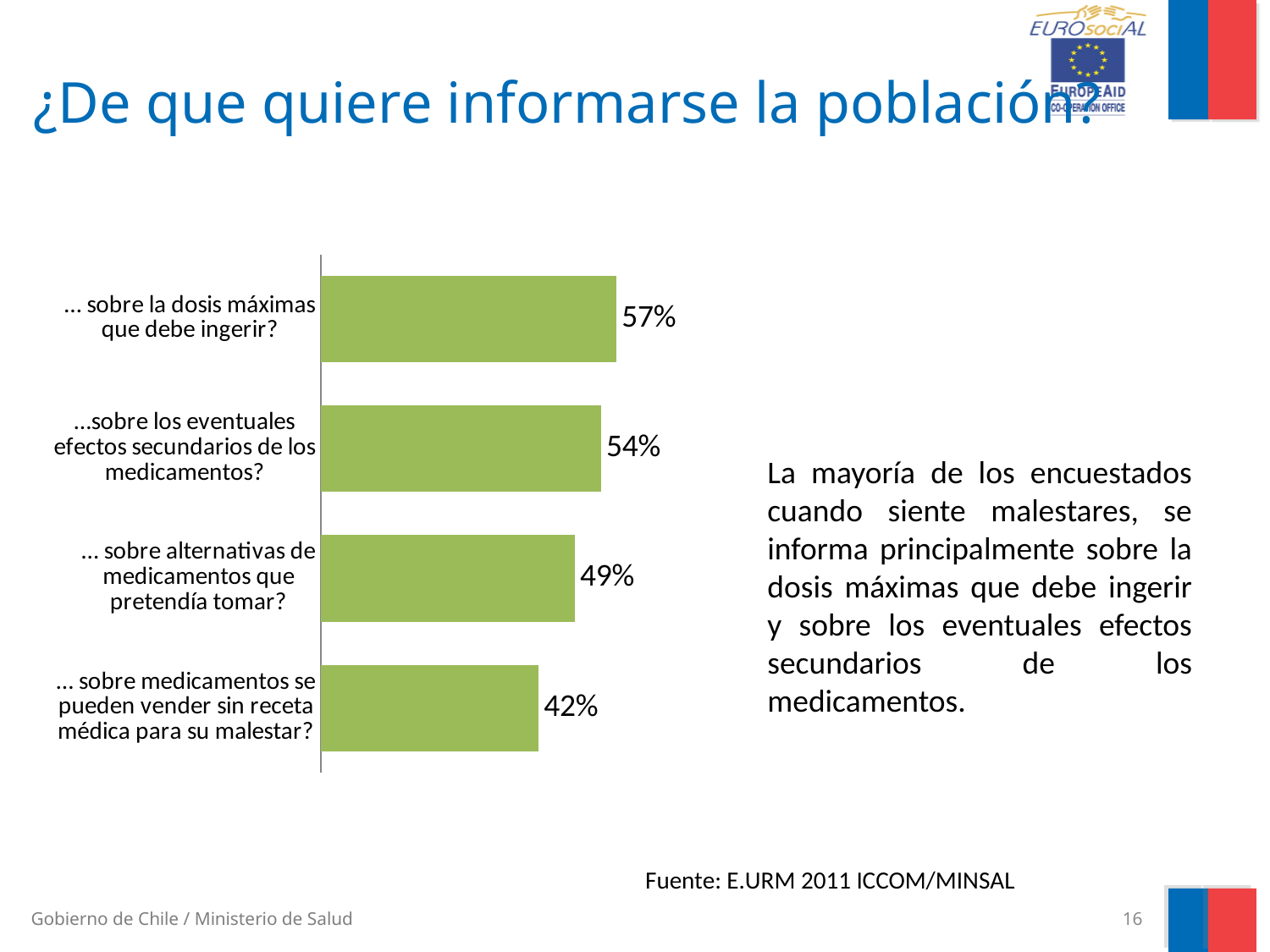
What is the value for "… sobre alternativas de medicamentos que pretendía tomar?"? 49% What colour are the bars in the chart? Green Which category has the lowest value? … sobre medicamentos se pueden vender sin receta médica para su malestar? Which category has the highest value? … sobre la dosis máximas que debe ingerir? Which is larger: the value for "… sobre alternativas de medicamentos que pretendía tomar?" or for "… sobre medicamentos se pueden vender sin receta médica para su malestar?"? … sobre alternativas de medicamentos que pretendía tomar? How many categories are shown in the chart? 4 What is the value for "… sobre la dosis máximas que debe ingerir?"? 57% What is the value for "…sobre los eventuales efectos secundarios de los medicamentos?"? 54% What is the value for "… sobre medicamentos se pueden vender sin receta médica para su malestar?"? 42% What is the difference between the values for "…sobre los eventuales efectos secundarios de los medicamentos?" and "… sobre alternativas de medicamentos que pretendía tomar?"? 5% What kind of chart is shown on the slide? Bar chart What is the difference between the highest and lowest values in the chart? 15%